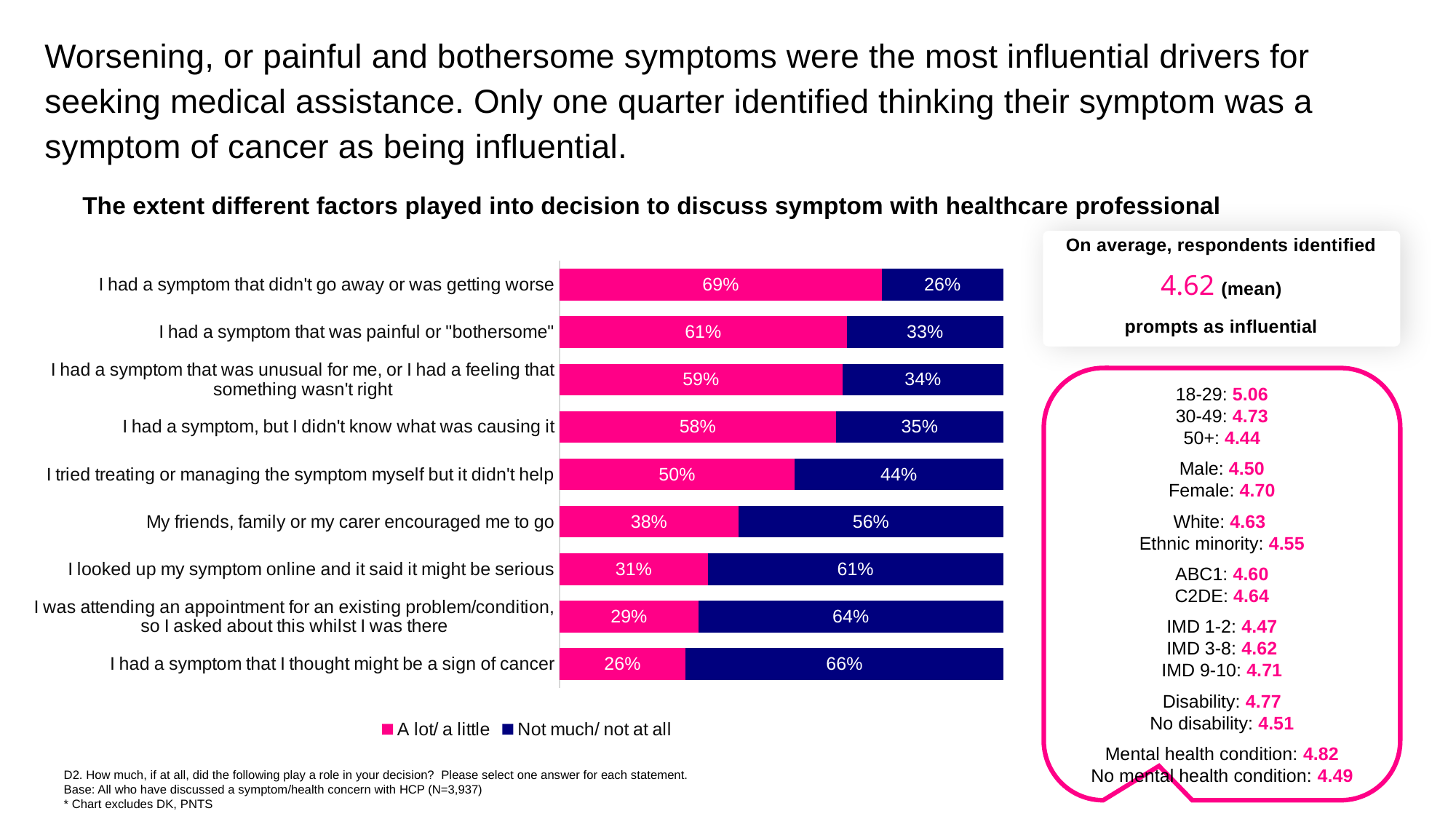
Which is larger: the "Not much/ not at all" value for "I tried treating or managing the symptom myself but it didn't help" or for "I had a symptom, but I didn't know what was causing it"? I tried treating or managing the symptom myself but it didn't help Which statement has the lowest "A lot/ a little" percentage? I had a symptom that I thought might be a sign of cancer What type of chart is used to show the extent different factors played into the decision? Stacked bar chart What is the difference between the "A lot/ a little" values for "I had a symptom that was painful or 'bothersome'" and "I looked up my symptom online and it said it might be serious"? 30% What percentage of respondents said "I had a symptom that didn't go away or was getting worse" played a role a lot/a little? 69% What is the total of the two segments for "I was attending an appointment for an existing problem/condition, so I asked about this whilst I was there"? 93% How many statements are shown in the bar chart? 9 What is the "A lot/ a little" value for "My friends, family or my carer encouraged me to go"? 38% What is the "Not much/ not at all" value for "I had a symptom that I thought might be a sign of cancer"? 66% What is the title of the chart? The extent different factors played into decision to discuss symptom with healthcare professional Which statement has the highest "A lot/ a little" percentage? I had a symptom that didn't go away or was getting worse How many series does the legend list? 2